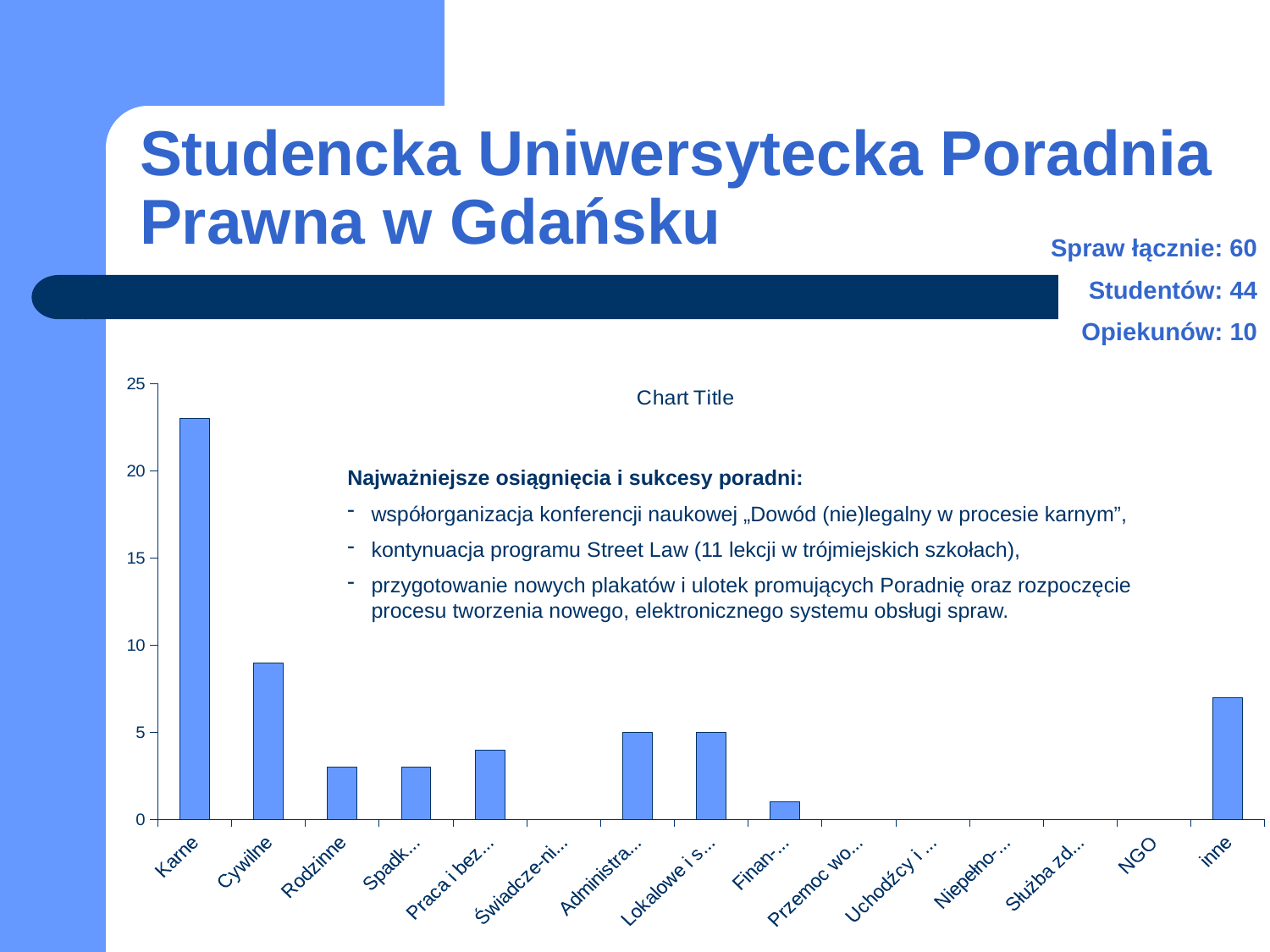
Is the value for inne greater or less than 5? greater How many categories are shown on the x axis of the chart? 15 Is the value for Cywilne greater or less than 10? less Which category has the highest bar in the chart? Karne Which category has the second-highest bar in the chart? Cywilne Which is larger, the value for Cywilne or the value for inne? Cywilne Which is larger, the value for Administra... or the value for Finan-...? Administra... What is the title shown on the chart? Chart Title Is the value for Finan-... greater or less than 5? less What kind of chart is shown on the slide? bar chart Which is larger, the value for Karne or the value for Cywilne? Karne